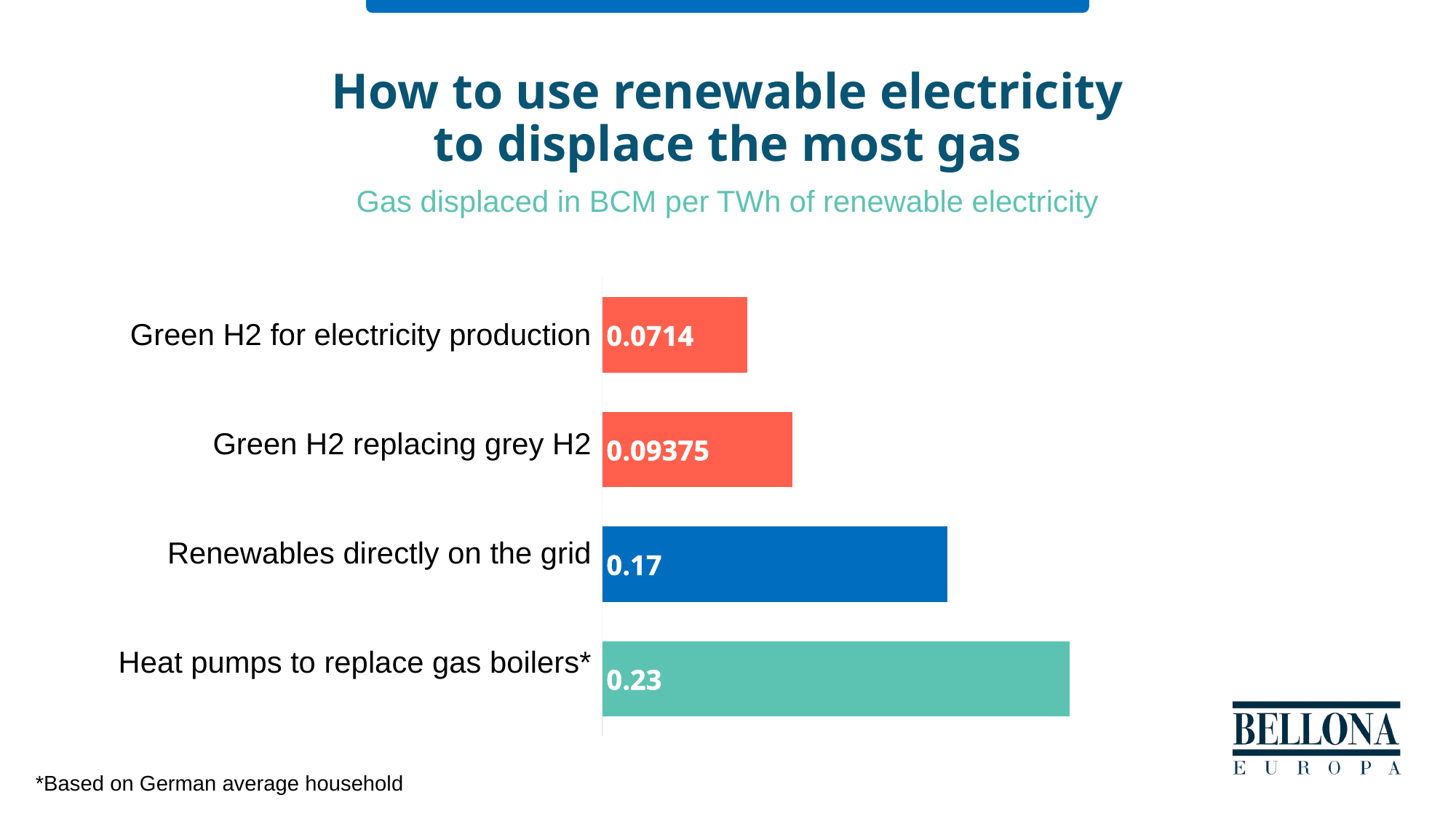
What unit does the chart subtitle say the values are measured in? BCM per TWh of renewable electricity Which is larger: the value for Green H2 replacing grey H2 or the value for Green H2 for electricity production? Green H2 replacing grey H2 What is the difference between the values for Heat pumps to replace gas boilers* and Renewables directly on the grid? 0.06 How many categories are shown in the chart? 4 Which category has the highest value? Heat pumps to replace gas boilers* What is the value for Heat pumps to replace gas boilers*? 0.23 What is the value for Green H2 for electricity production? 0.0714 What is the value for Green H2 replacing grey H2? 0.09375 What colour is the bar for Renewables directly on the grid? Blue What is the value for Renewables directly on the grid? 0.17 What kind of chart is shown on the slide? Bar chart Which category has the lowest value? Green H2 for electricity production